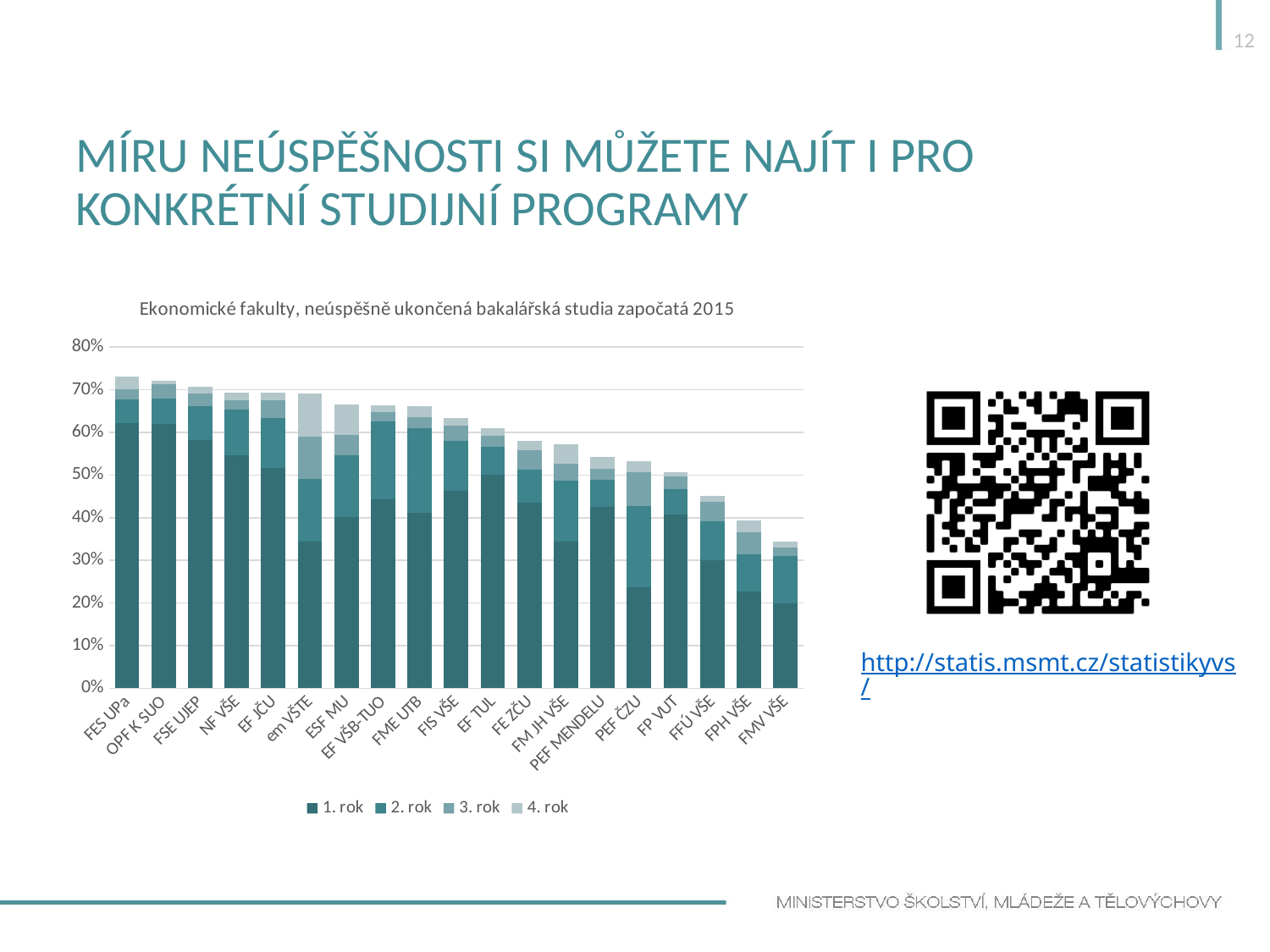
What is the title of the chart? Ekonomické fakulty, neúspěšně ukončená bakalářská studia započatá 2015 Which faculty has the highest total bar in the chart? FES UPa Is the 1. rok segment for PEF ČZU greater or less than 30%? less How many series does the chart legend list? 4 Is the total bar for FMV VŠE greater or less than 40%? less Do the total bar heights generally rise or fall from left to right along the x axis? fall Is the total bar for FFÚ VŠE greater or less than 50%? less Which faculty has the lowest total bar in the chart? FMV VŠE What kind of chart is shown on the slide? stacked bar chart Which has the larger total bar, FES UPa or FMV VŠE? FES UPa How many faculties (categories) are shown on the x axis of the chart? 19